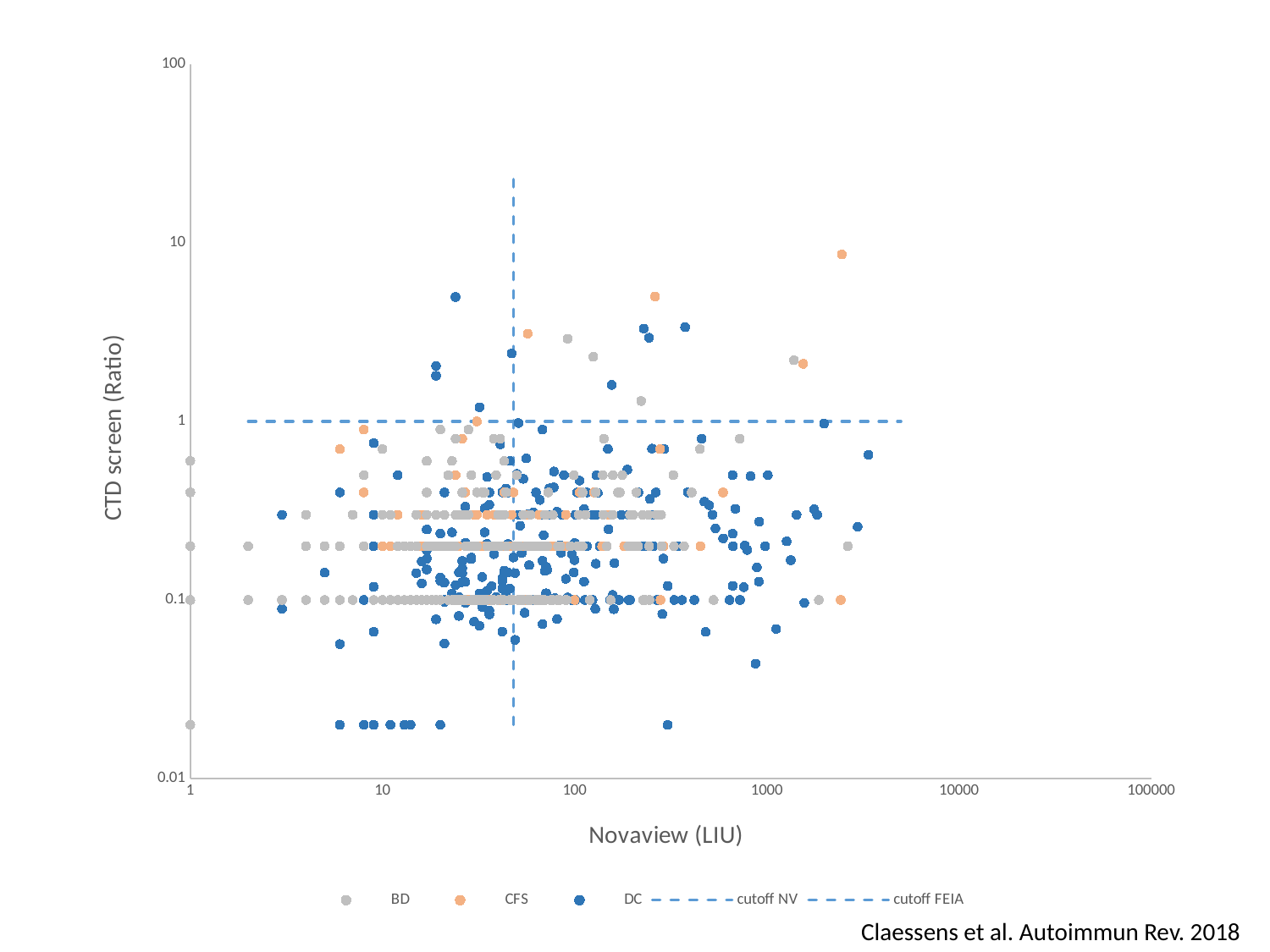
At what CTD screen ratio is the horizontal dashed cutoff line drawn? 1 What is the label of the x axis? Novaview (LIU) Is the vertical dashed cutoff line at a Novaview value greater or less than 10? greater Which series contains the point with the highest CTD screen ratio? CFS Is the highest CTD screen ratio plotted greater or less than 10? less What is the lowest value shown on the y axis? 0.01 Is the vertical dashed cutoff line at a Novaview value greater or less than 100? less Which series has more plotted points, DC or CFS? DC How many entries does the legend list? 5 What is the highest value shown on the x axis? 100000 What kind of chart is shown on the slide? scatter plot What is the label of the y axis? CTD screen (Ratio)